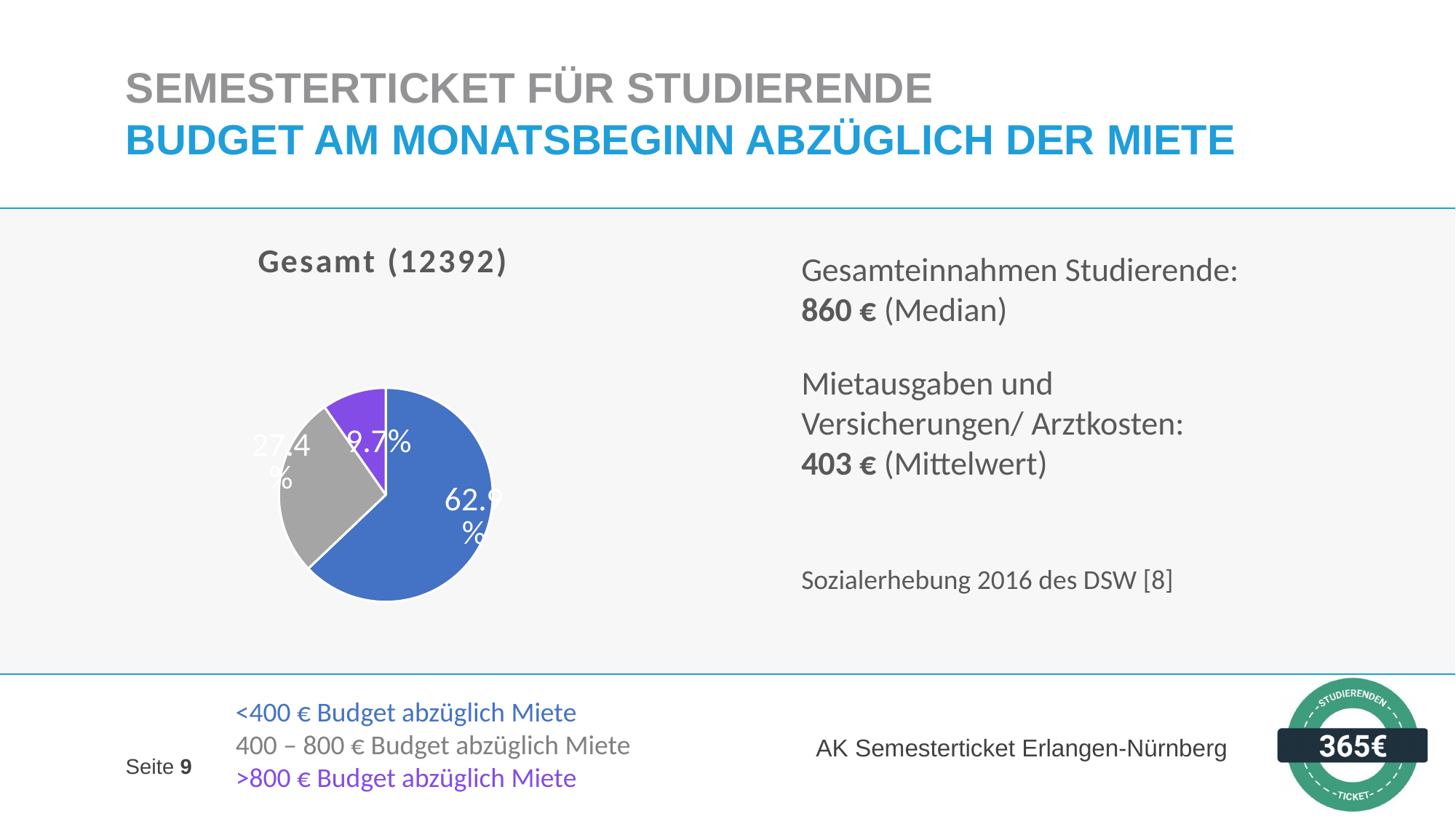
What share of the pie is the grey slice (400 – 800 € Budget abzüglich Miete)? 27.4% What share of the pie is the purple slice (>800 € Budget abzüglich Miete)? 9.7% Which category has the largest share of the pie? <400 € Budget abzüglich Miete How many slices does the pie chart have? 3 What is the title of the pie chart? Gesamt (12392) What is the difference in percentage points between the 400 – 800 € slice and the >800 € slice? 17.7 What colour is the slice for >800 € Budget abzüglich Miete? purple What kind of chart is shown on the slide? pie chart Which slice is larger: 400 – 800 € Budget abzüglich Miete or >800 € Budget abzüglich Miete? 400 – 800 € Budget abzüglich Miete Which category has the smallest share of the pie? >800 € Budget abzüglich Miete What share of the pie is the blue slice (<400 € Budget abzüglich Miete)? 62.9% What is the difference in percentage points between the <400 € slice and the 400 – 800 € slice? 35.5